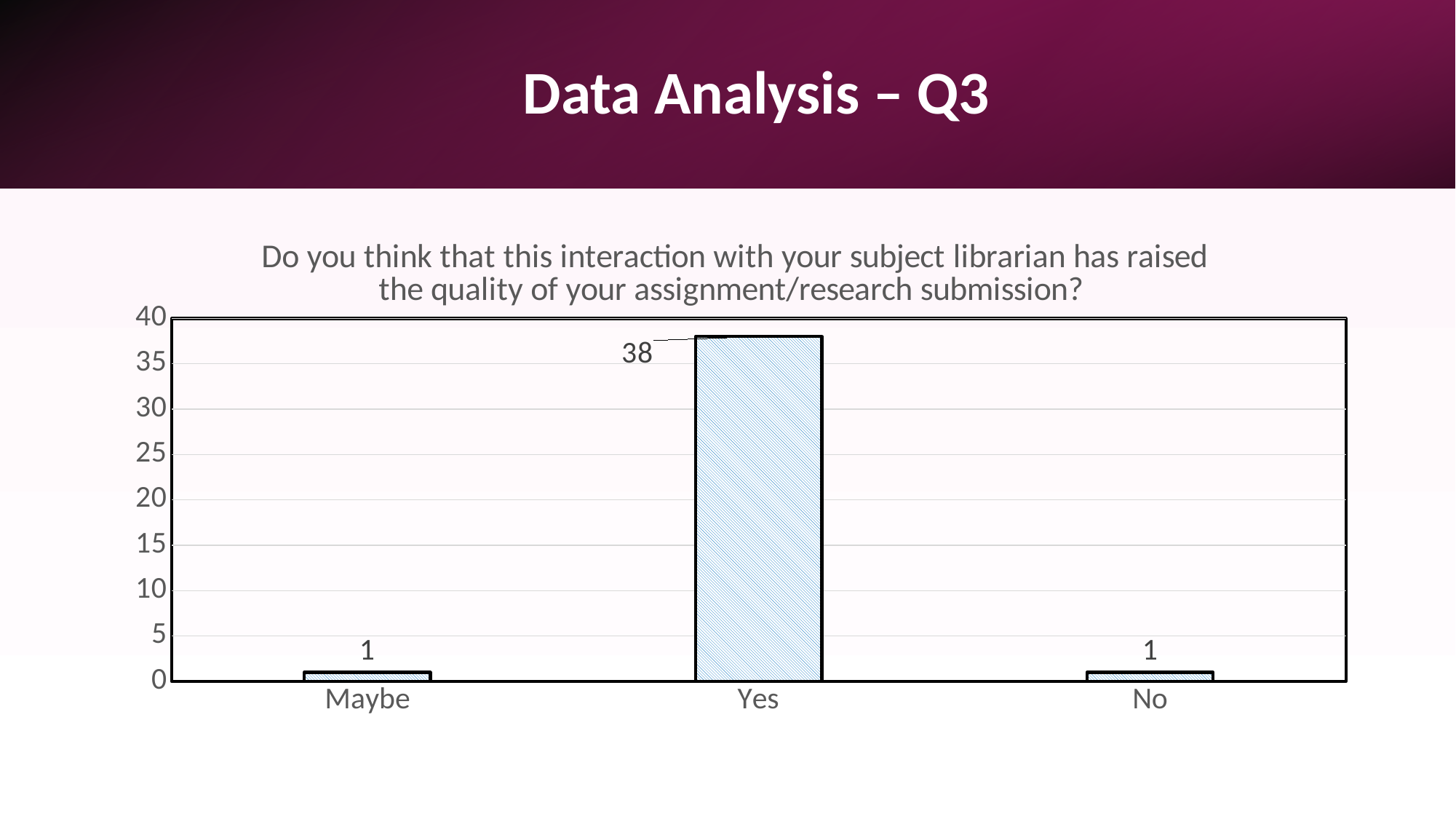
How many categories are shown on the x axis? 3 What is the difference between the values for Yes and Maybe? 37 What kind of chart is shown on the slide? bar chart Is the value for Yes greater or less than 35? greater Which is larger, the value for Yes or the value for Maybe? Yes What is the difference between the values for Yes and No? 37 What is the value for No? 1 What is the value for Yes? 38 Which category has the highest value? Yes Is the value for No greater or less than 5? less What is the title of the chart? Do you think that this interaction with your subject librarian has raised the quality of your assignment/research submission? What is the value for Maybe? 1